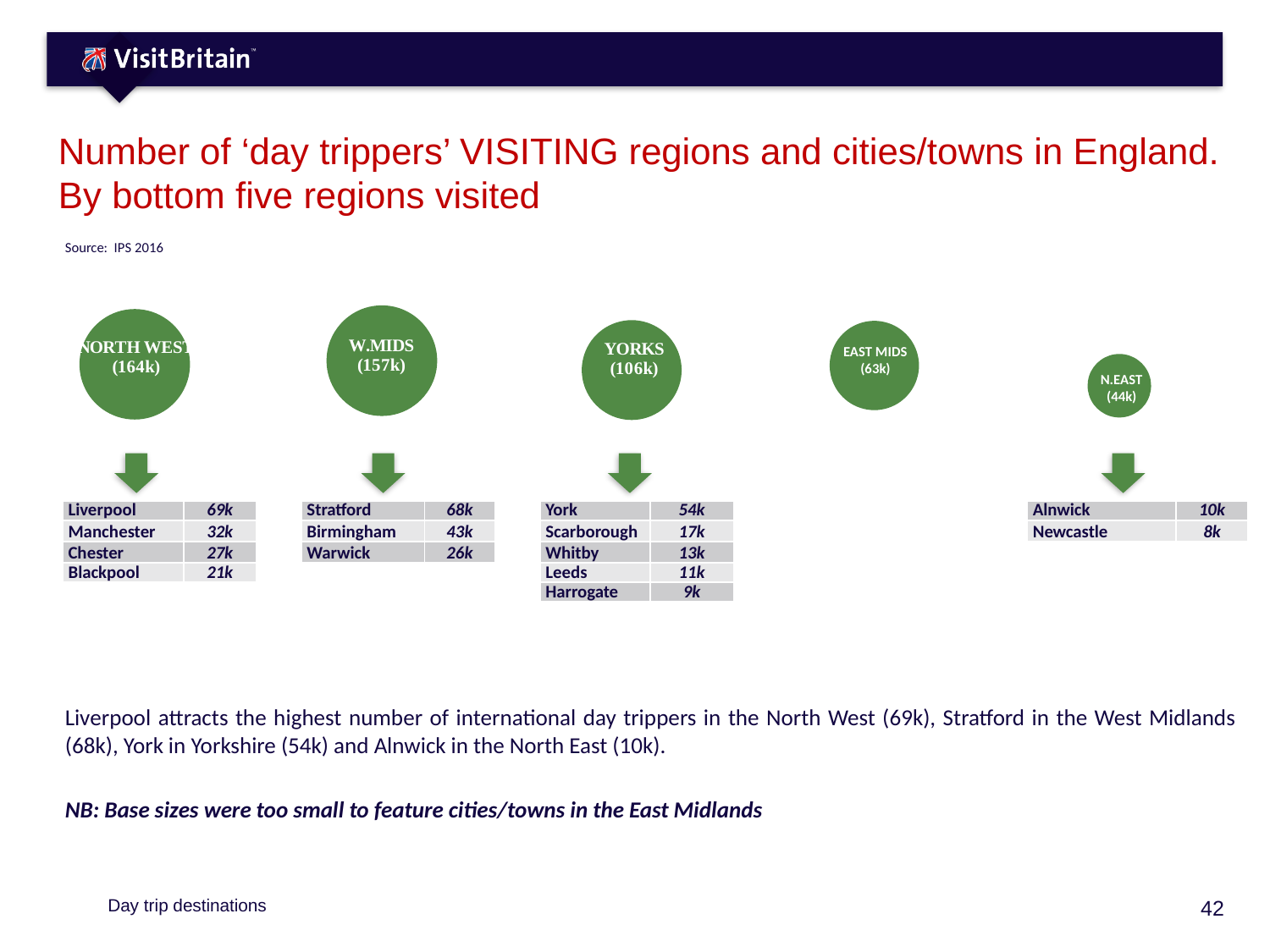
How many day trippers visited Liverpool according to the North West table? 69k Which of the five regions shown has the lowest number of day trippers? N.East Which has more day trippers, Yorkshire or the East Midlands? Yorkshire Which region has no cities/towns listed beneath its bubble? East Mids What is the difference in day trippers between Stratford (68k) and Birmingham (43k)? 25k Which city/town in the Yorkshire table has the lowest number of day trippers? Harrogate Which of the five regions shown has the highest number of day trippers? North West What is the number of day trippers shown for the East Midlands region? 63k What kind of chart is used to show the regional day tripper figures? Bubble chart What is the number of day trippers shown for the North West region? 164k What is the difference in day trippers between the North West (164k) and the West Midlands (157k)? 7k How many regions are shown as bubbles on the slide? 5